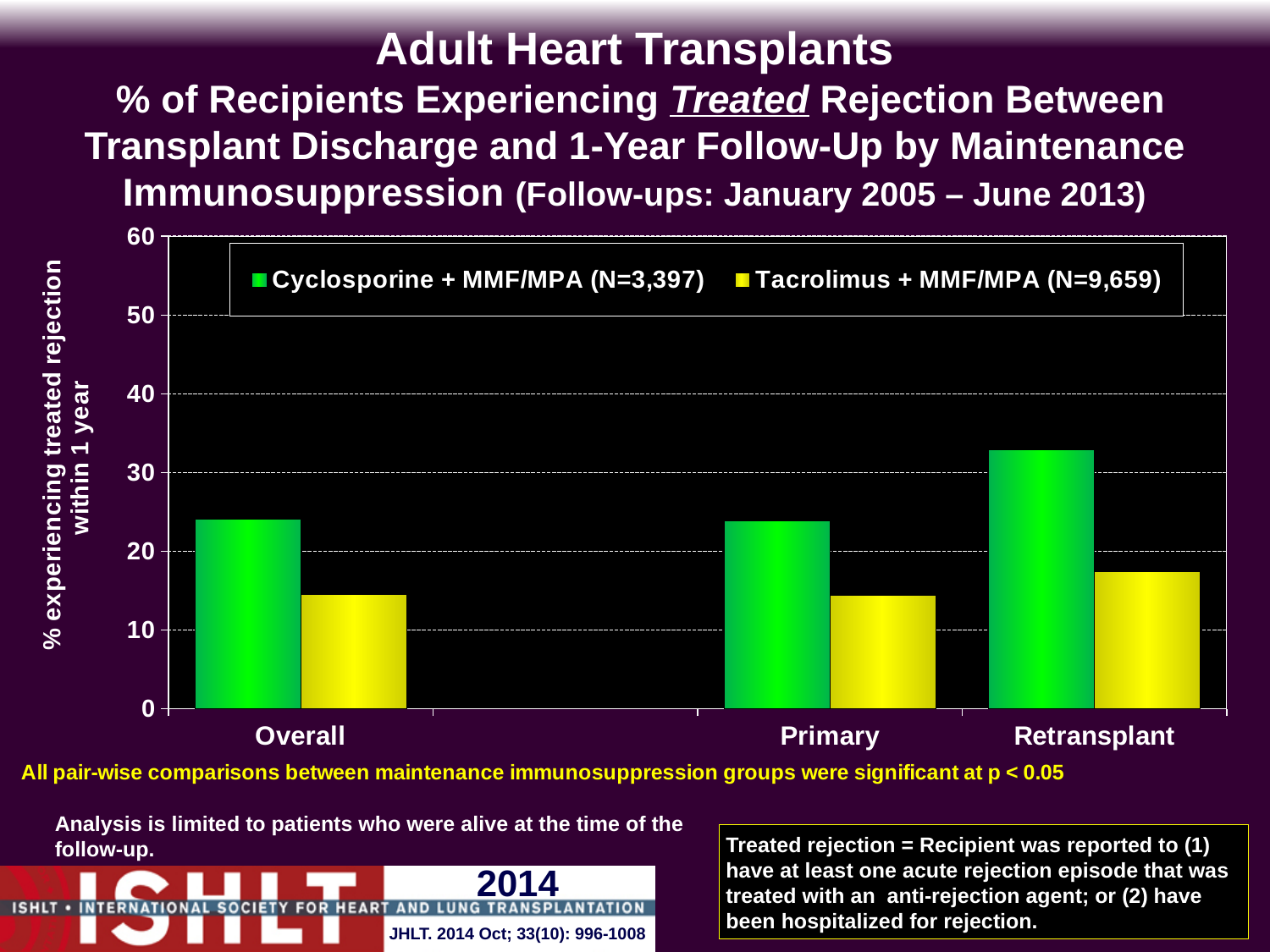
Is the value for Tacrolimus + MMF/MPA in the Overall category greater or less than 20? less Which category has the highest value for Cyclosporine + MMF/MPA? Retransplant What kind of chart is shown on the slide? bar chart How many series does the legend list? 2 What is the N value given in the legend for Tacrolimus + MMF/MPA? N=9,659 Is the value for Cyclosporine + MMF/MPA in the Retransplant category greater or less than 30? greater Which category has the highest value for Tacrolimus + MMF/MPA? Retransplant In the Overall category, which series has the larger value, Cyclosporine + MMF/MPA or Tacrolimus + MMF/MPA? Cyclosporine + MMF/MPA In the Retransplant category, which series has the larger value, Cyclosporine + MMF/MPA or Tacrolimus + MMF/MPA? Cyclosporine + MMF/MPA What is the N value given in the legend for Cyclosporine + MMF/MPA? N=3,397 Is the value for Cyclosporine + MMF/MPA in the Primary category greater or less than 20? greater How many categories are shown on the x axis? 3